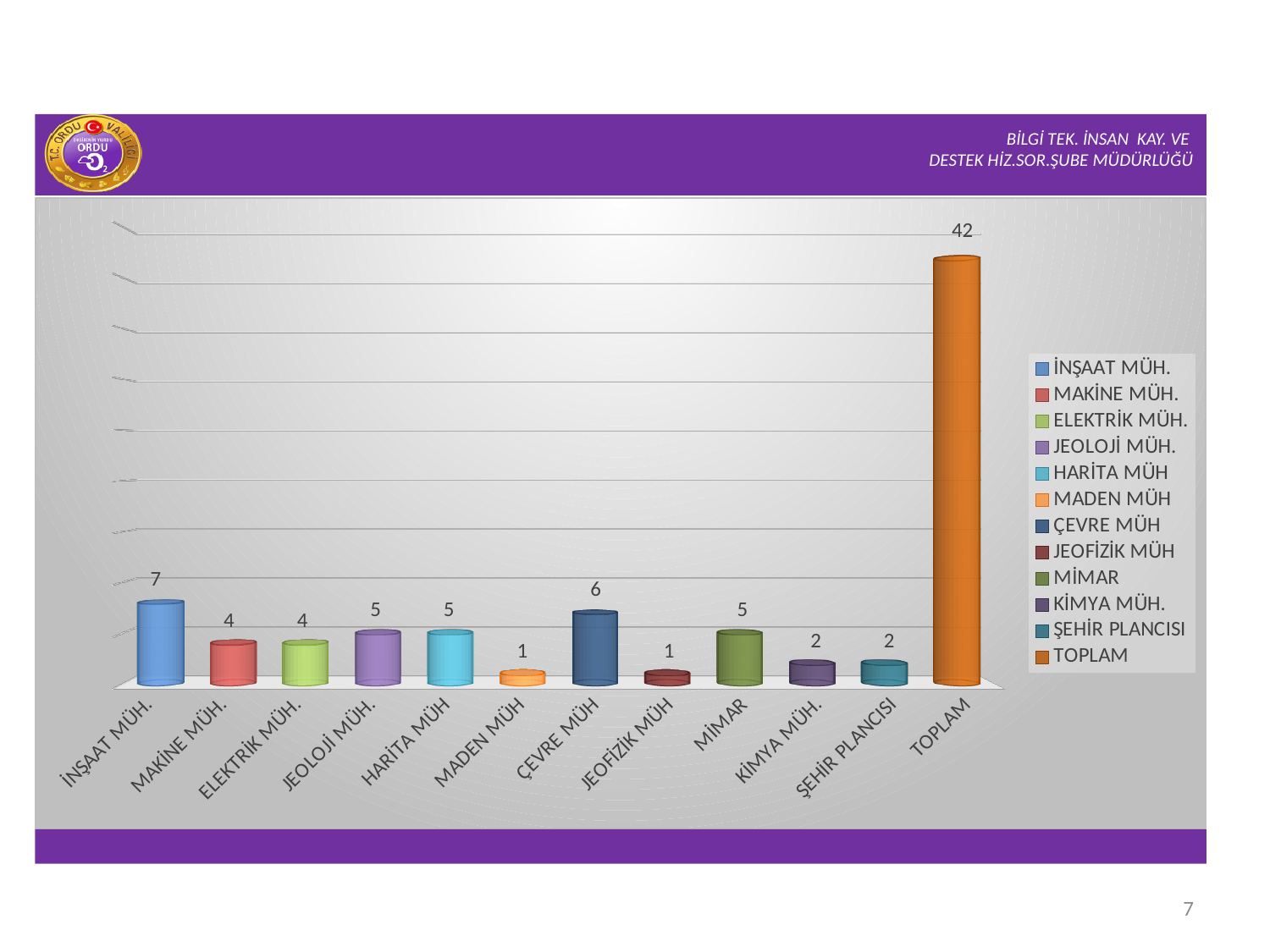
How many entries does the legend list? 12 What is the value for ŞEHİR PLANCISI? 2 Which is larger, the value for ÇEVRE MÜH or the value for MİMAR? ÇEVRE MÜH What colour is the TOPLAM bar? Orange What is the difference between the values for İNŞAAT MÜH. and MAKİNE MÜH.? 3 What kind of chart is shown on the slide? Bar chart Which categories have the lowest value? MADEN MÜH and JEOFİZİK MÜH How many categories are shown on the x axis? 12 What is the value for İNŞAAT MÜH.? 7 Excluding the TOPLAM bar, which category has the highest value? İNŞAAT MÜH. What is the value shown for TOPLAM? 42 What is the value for ÇEVRE MÜH? 6